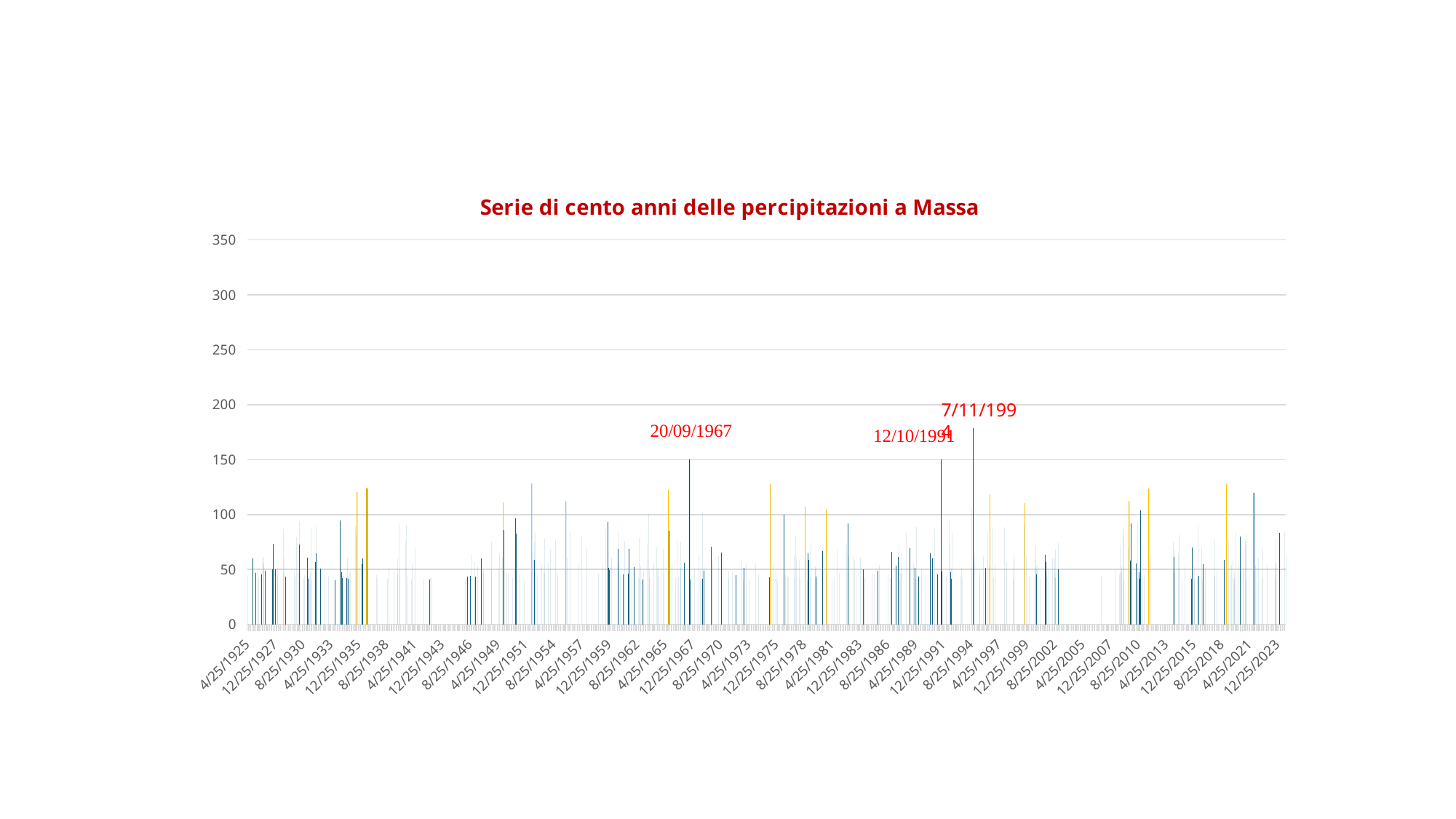
What kind of chart is shown on the slide? bar chart What is the title of the chart? Serie di cento anni delle percipitazioni a Massa How many dates are annotated with labels on the chart? 3 What is the last date label on the horizontal axis? 12/25/2023 What is the highest tick value shown on the vertical axis? 350 Is the value for 7/11/1994 greater or less than 200? less Is the value for 20/09/1967 greater or less than 100? greater Is the value for 12/10/1991 greater or less than 100? greater Which is larger, the value for 7/11/1994 or the value for 20/09/1967? 7/11/1994 What is the first date label on the horizontal axis? 4/25/1925 Which of the annotated dates has the highest bar? 7/11/1994